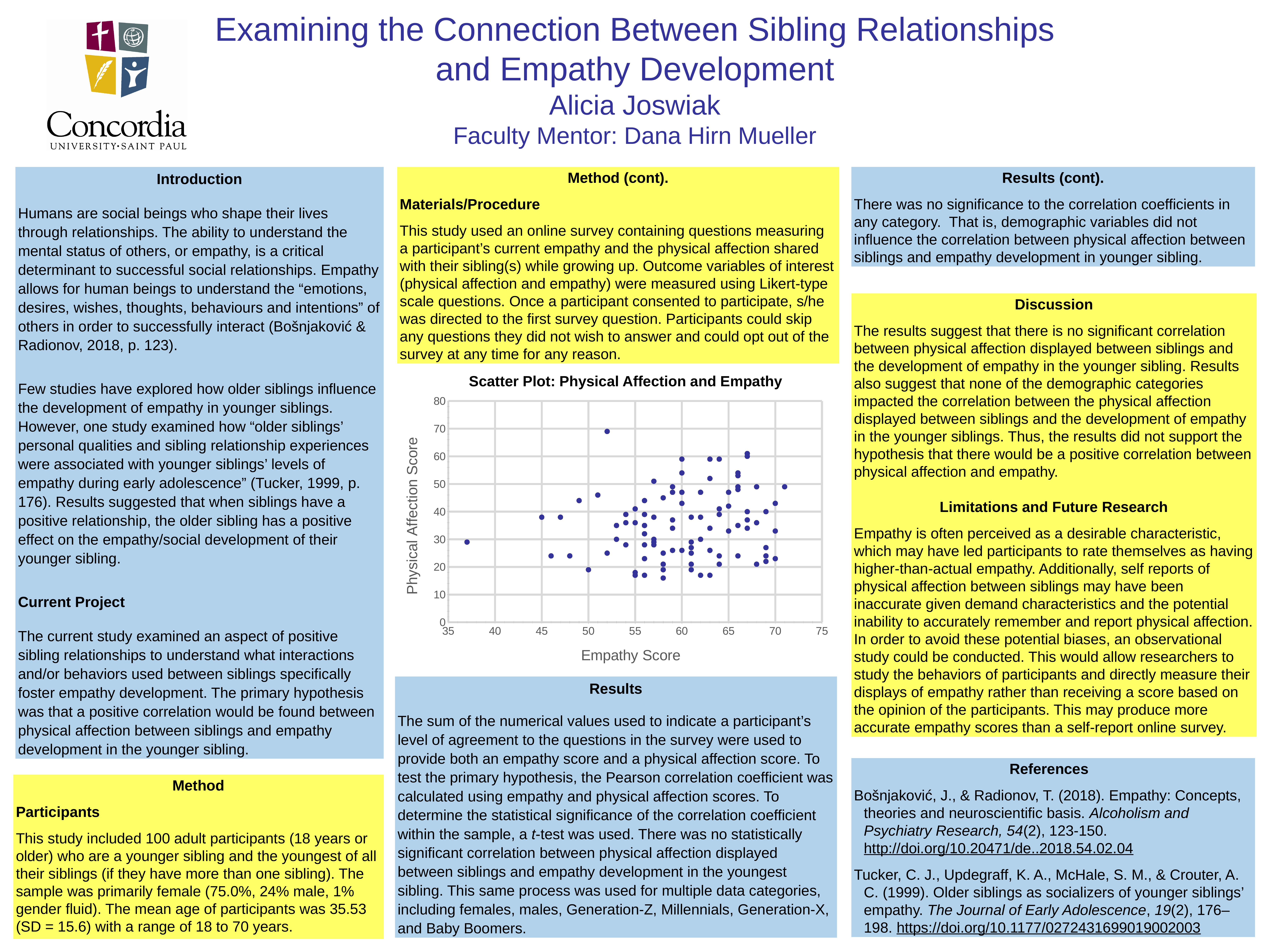
What is the title of the chart on the slide? Scatter Plot: Physical Affection and Empathy What is the label of the x axis of the scatter plot? Empathy Score Is the lowest empathy score plotted on the chart greater or less than 40? less Is the highest physical affection score plotted on the chart greater or less than 60? greater What kind of chart is shown on the slide? scatter plot Is the physical affection score of the leftmost point on the chart greater or less than 40? less